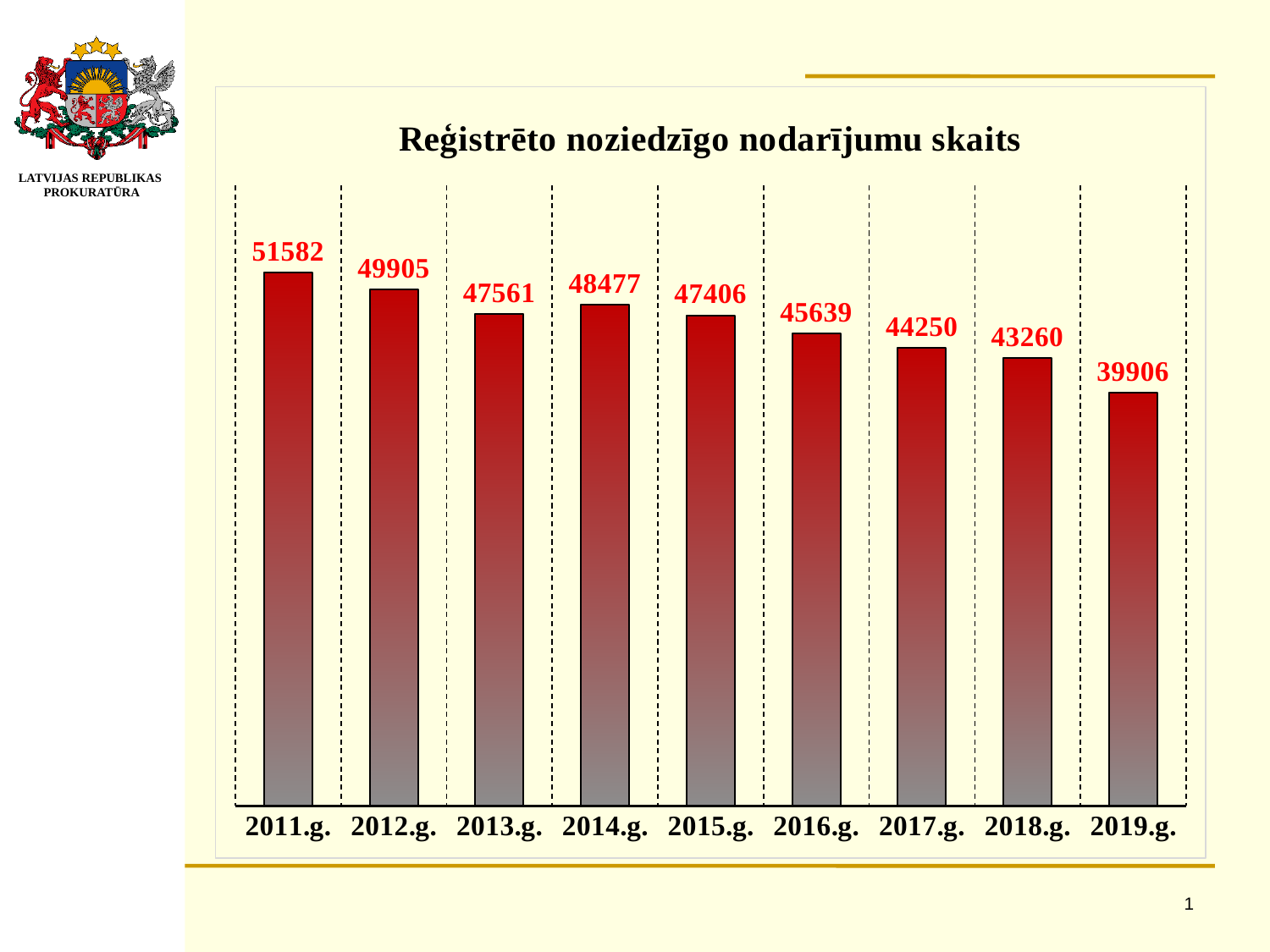
Which year has the highest value? 2011.g. What is the difference between the values for 2011.g. and 2019.g.? 11676 What is the value for 2011.g.? 51582 What is the difference between the values for 2013.g. and 2014.g.? 916 How many years are shown on the x axis? 9 Which year has the lowest value? 2019.g. Do the values generally rise or fall from 2011.g. to 2019.g.? fall What is the value for 2015.g.? 47406 What is the title of the chart? Reģistrēto noziedzīgo nodarījumu skaits What is the value for 2019.g.? 39906 Which is larger, the value for 2014.g. or the value for 2013.g.? 2014.g. What kind of chart is this? bar chart